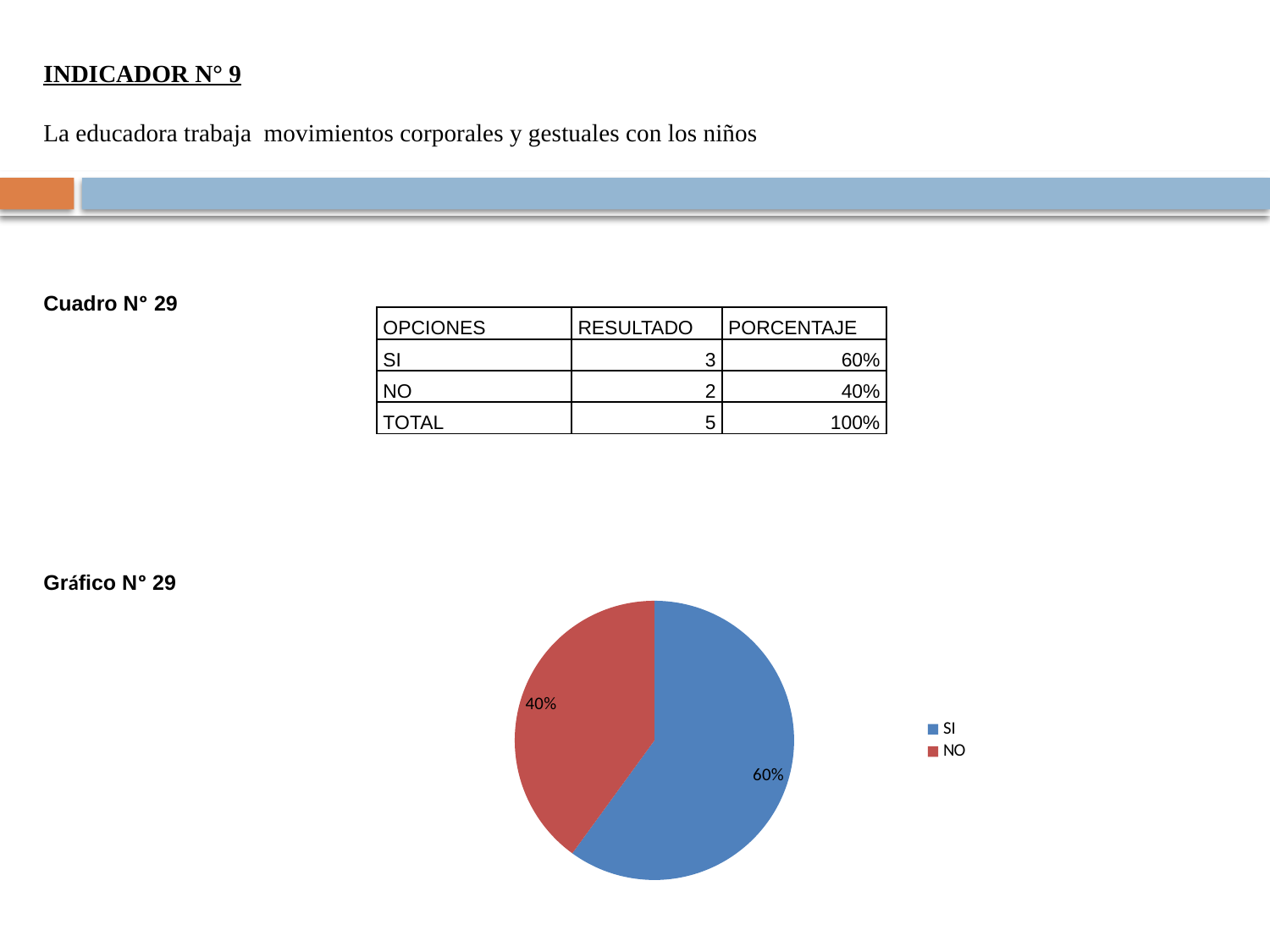
Which slice of the pie chart is the largest? SI Which slice of the pie chart is the smallest? NO What share of the pie does the NO slice represent? 40% What colour is the NO slice in the pie chart? red What percentage does the SI slice show in the pie chart? 60% What colour is the SI slice in the pie chart? blue What percentage does the NO slice show in the pie chart? 40% What is the difference in percentage points between the SI and NO slices? 20% How many slices does the pie chart have? 2 How many entries does the legend of the pie chart list? 2 What kind of chart is shown on the slide? pie chart Which is larger in the pie chart, SI or NO? SI